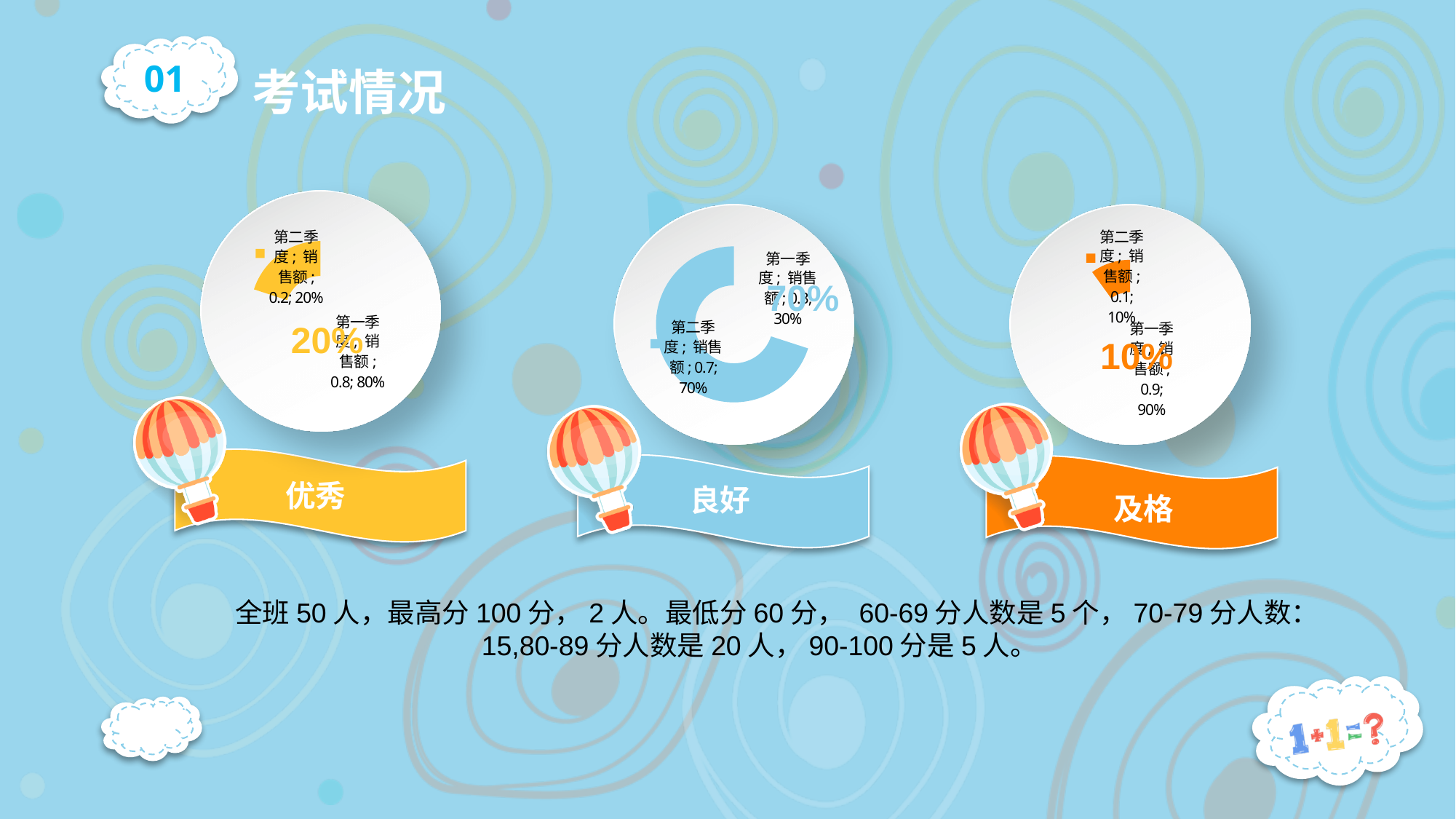
In the middle chart (above 良好), which is larger, 第一季度 or 第二季度? 第二季度 In the left chart (above 优秀), what is the difference between the 第一季度 share and the 第二季度 share? 60 percentage points In the right chart (above 及格), what is the value shown for 第二季度 销售额? 10% In the left chart (above 优秀), what is the value shown for 第一季度 销售额? 80% In the middle chart (above 良好), which category has the smallest share? 第一季度 In the right chart (above 及格), which category has the largest share? 第一季度 How many categories does the left chart (above 优秀) show? 2 In the middle chart (above 良好), what is the value shown for 第二季度 销售额? 70% In the left chart (above 优秀), what is the value shown for 第二季度 销售额? 20% In the middle chart (above 良好), what is the value shown for 第一季度 销售额? 30% In the right chart (above 及格), what is the value shown for 第一季度 销售额? 90% What kind of chart is the middle chart (above 良好)? doughnut chart